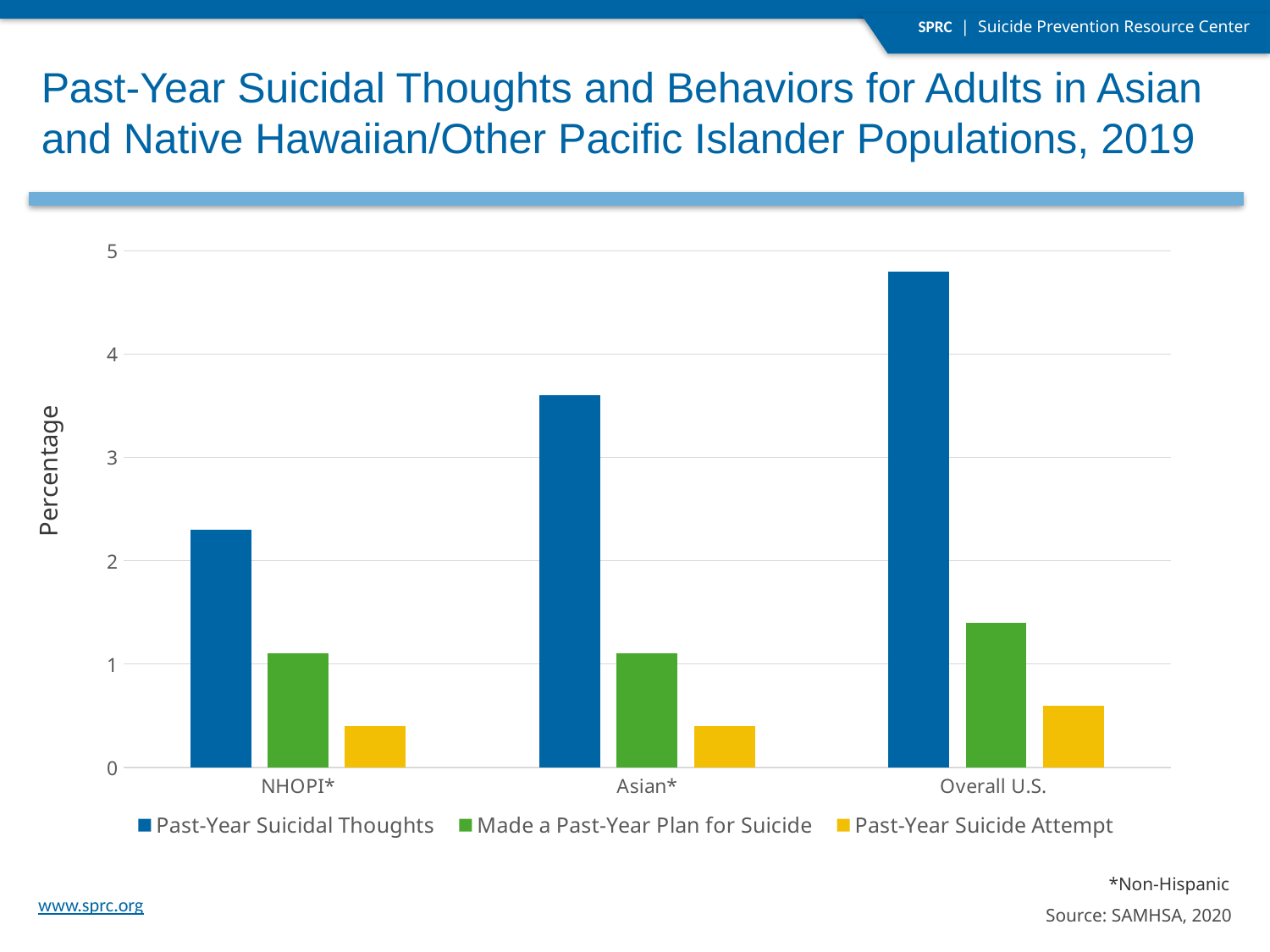
Is the value for Past-Year Suicide Attempt for Overall U.S. greater or less than 1? less Which category has the highest value for Past-Year Suicidal Thoughts? Overall U.S. Which is larger: Made a Past-Year Plan for Suicide for Overall U.S. or for Asian*? Overall U.S. How many series does the legend list? 3 What is the label on the y axis? Percentage How many population categories are shown on the x axis? 3 Is the value for Past-Year Suicidal Thoughts for Asian* greater or less than 3? greater Is the value for Past-Year Suicidal Thoughts for NHOPI* greater or less than 3? less What kind of chart is shown on the slide? Bar chart Which category has the lowest value for Past-Year Suicidal Thoughts? NHOPI* Which is larger: Past-Year Suicidal Thoughts for Asian* or for NHOPI*? Asian*